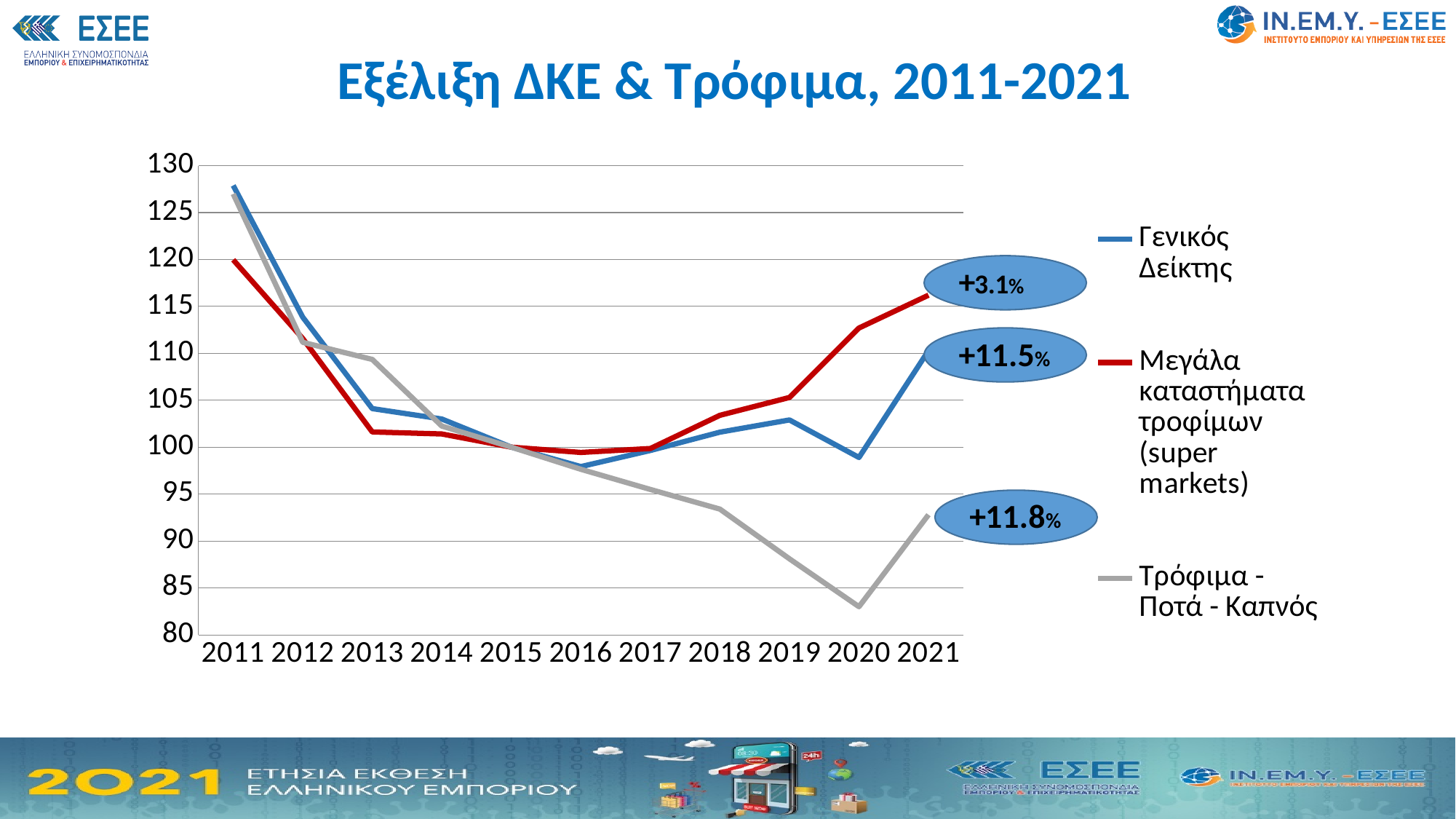
Which series has the lowest value in 2020? Τρόφιμα - Ποτά - Καπνός Is the value for Μεγάλα καταστήματα τροφίμων (super markets) in 2021 greater or less than 115? greater Is the value for Τρόφιμα - Ποτά - Καπνός in 2020 greater or less than 85? less What is the title of the chart? Εξέλιξη ΔΚΕ & Τρόφιμα, 2011-2021 Does the Τρόφιμα - Ποτά - Καπνός line rise or fall from 2011 to 2020? fall What kind of chart is shown on the slide? line chart Which series has the highest value in 2021? Μεγάλα καταστήματα τροφίμων (super markets) In 2020, which is higher: Μεγάλα καταστήματα τροφίμων (super markets) or Τρόφιμα - Ποτά - Καπνός? Μεγάλα καταστήματα τροφίμων (super markets) Is the value for Γενικός Δείκτης in 2019 greater or less than 105? less How many years are shown on the x axis? 11 How many series does the legend list? 3